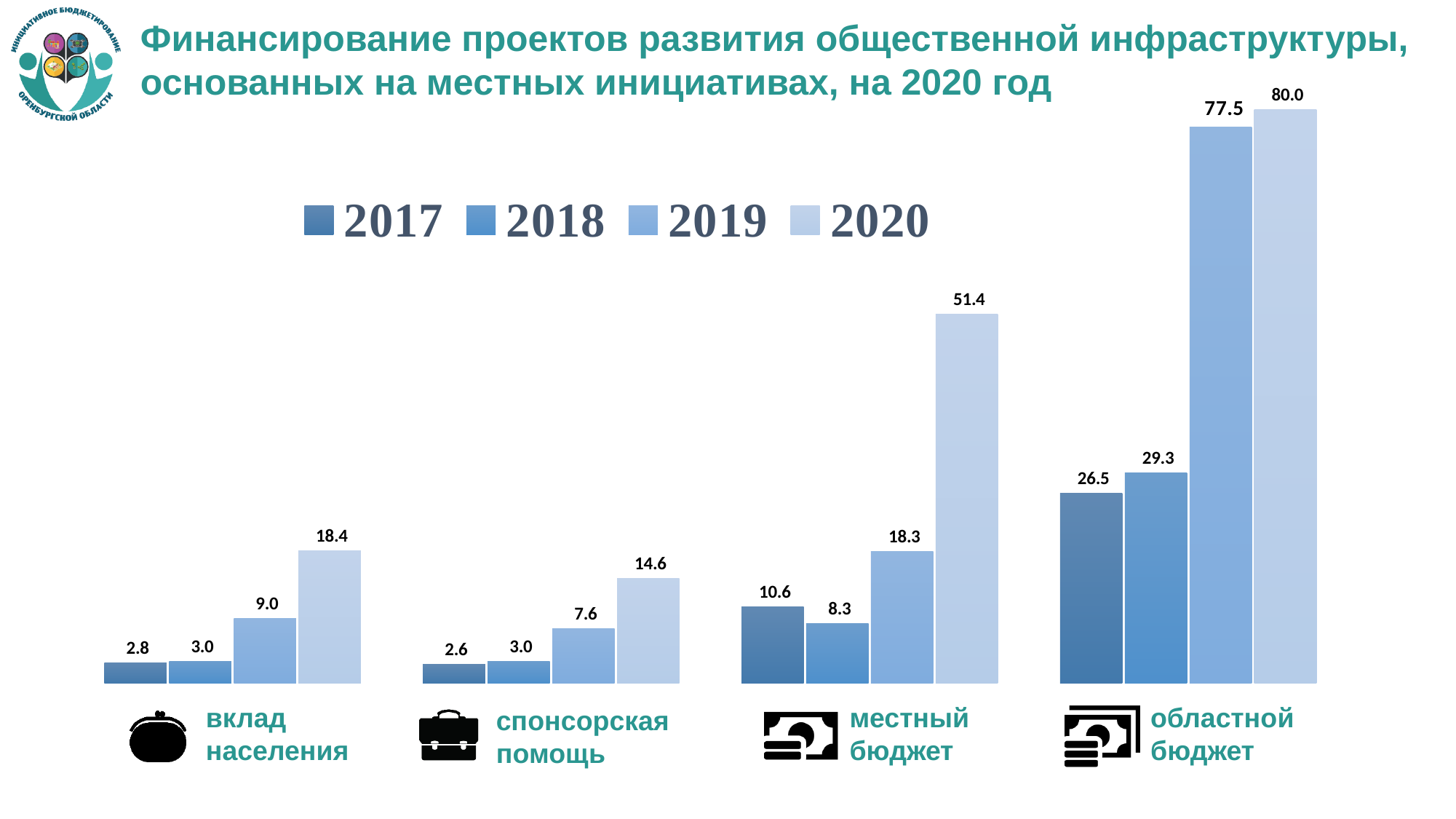
What is the value for вклад населения in 2018? 3.0 Do the values for областной бюджет rise or fall from 2017 to 2020? rise What kind of chart is shown on the slide? bar chart Which category has the lowest value in 2017? спонсорская помощь What is the value for спонсорская помощь in 2019? 7.6 What is the value for местный бюджет in 2017? 10.6 Which is larger: the 2019 value for вклад населения or the 2019 value for спонсорская помощь? вклад населения How many categories are shown on the x axis? 4 Which category has the highest value in 2020? областной бюджет What is the difference between the 2020 and 2019 values for местный бюджет? 33.1 How many series does the legend list? 4 What is the value for областной бюджет in 2020? 80.0